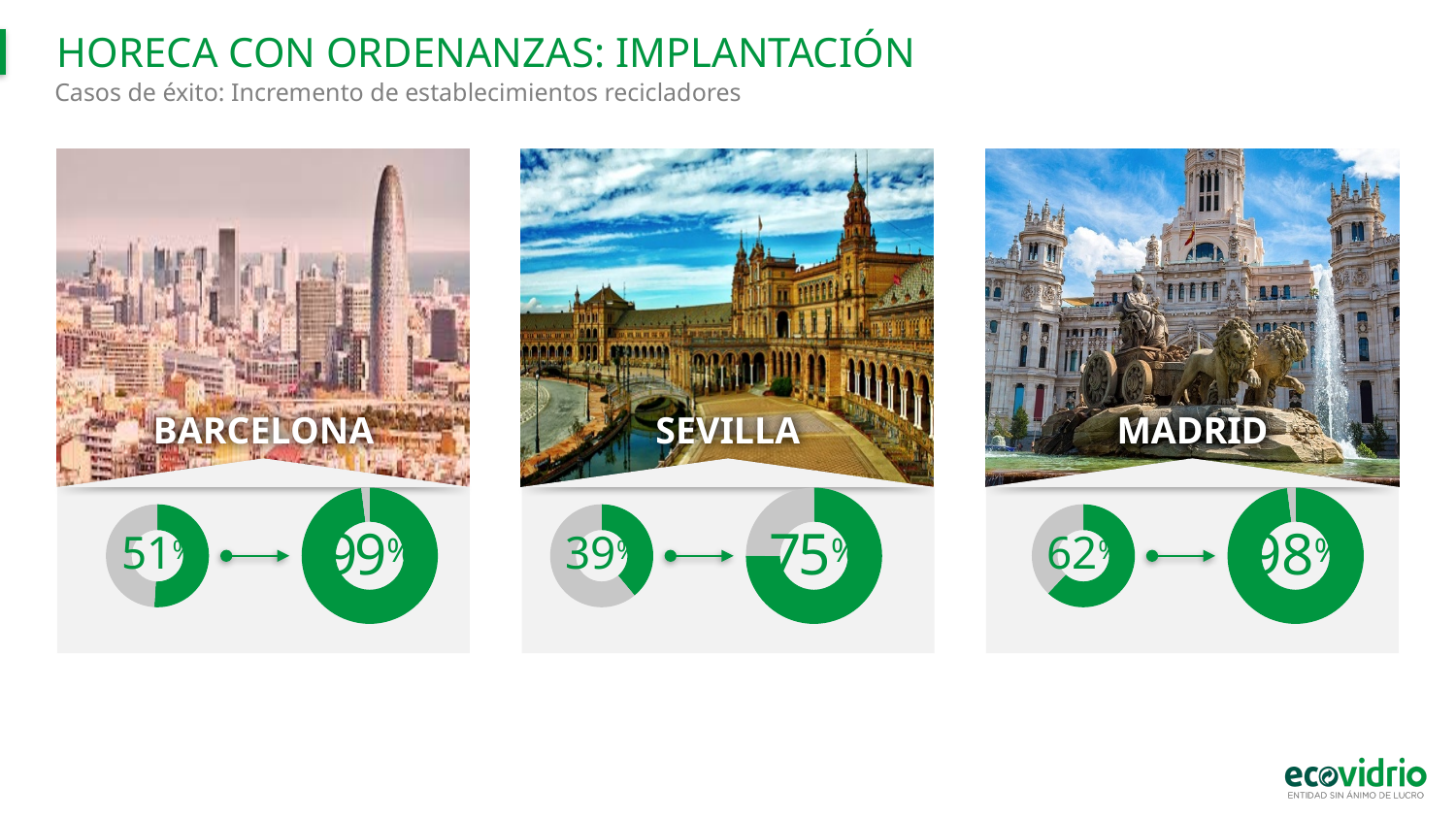
Which city has the highest final value in its right donut chart? Barcelona In the Madrid panel, what is the value shown in the right donut chart? 98% In the Barcelona panel, by how many percentage points does the value increase from the left donut to the right donut? 48 percentage points In the Madrid panel, what is the value shown in the left donut chart? 62% In the Sevilla panel, by how many percentage points does the value increase from the left donut to the right donut? 36 percentage points Which city has the lowest starting value in its left donut chart? Sevilla In the Barcelona panel, what is the value shown in the left donut chart? 51% In the Barcelona panel, what is the value shown in the right donut chart? 99% In the Sevilla panel, what is the value shown in the left donut chart? 39% What kind of chart is used to show the percentages for each city? Donut (pie) chart In the Sevilla panel, what is the value shown in the right donut chart? 75% Is the starting value for Madrid larger than the starting value for Barcelona? Yes, Madrid (62% vs 51%)